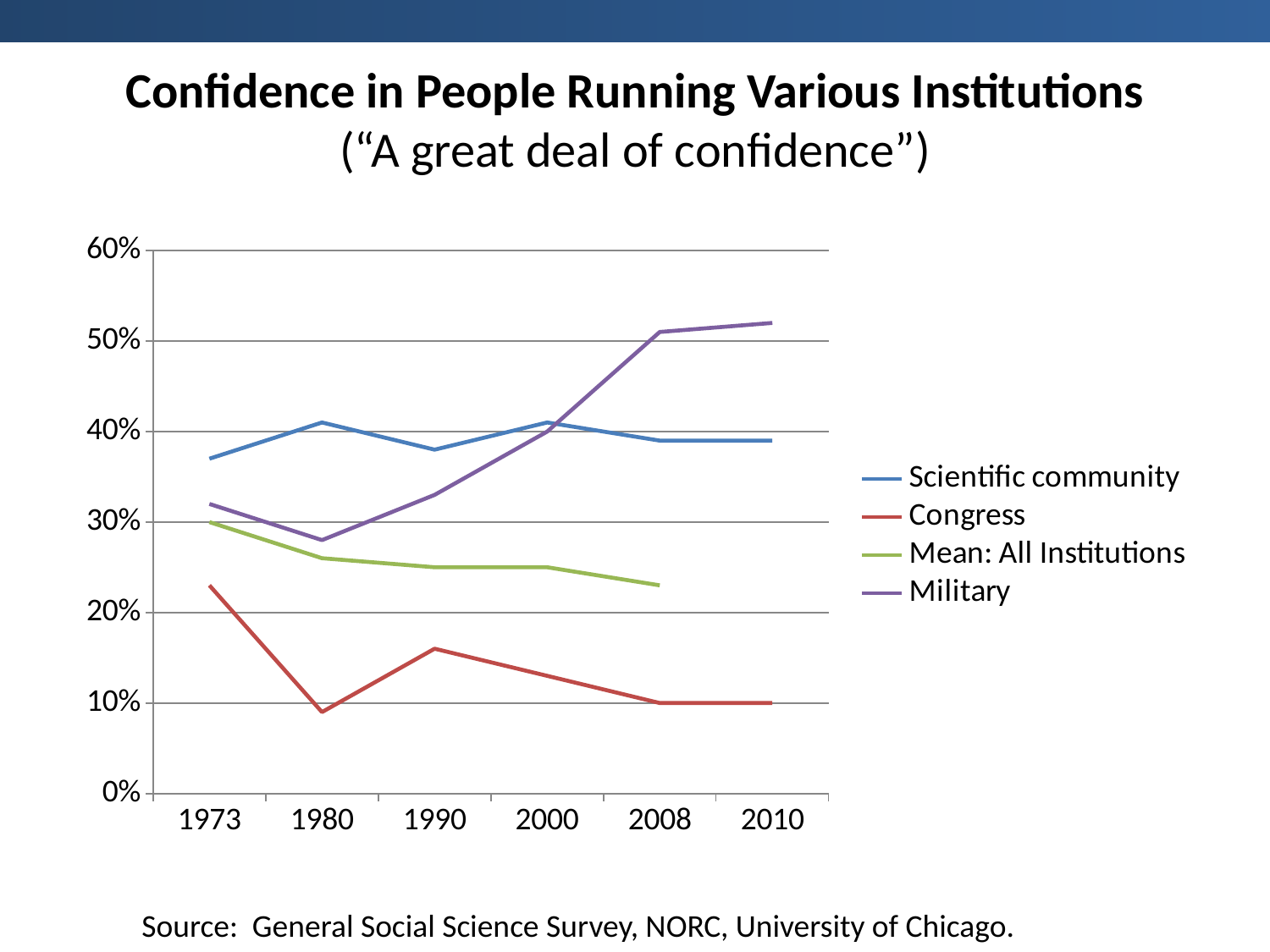
In 2010, which is larger: Military or Scientific community? Military Does the Military line rise or fall from 1980 to 2010? rise Is the value for Scientific community in 1973 greater or less than 35%? greater In 1973, which is larger: Congress or Mean: All Institutions? Mean: All Institutions Is the value for Military in 2010 greater or less than 50%? greater How many years are shown on the x axis? 6 Which series has the lowest value in 1973? Congress What kind of chart is shown on the slide? line chart Which series has the highest value in 2010? Military Does the Mean: All Institutions line rise or fall from 1973 to 2008? fall How many series does the legend list? 4